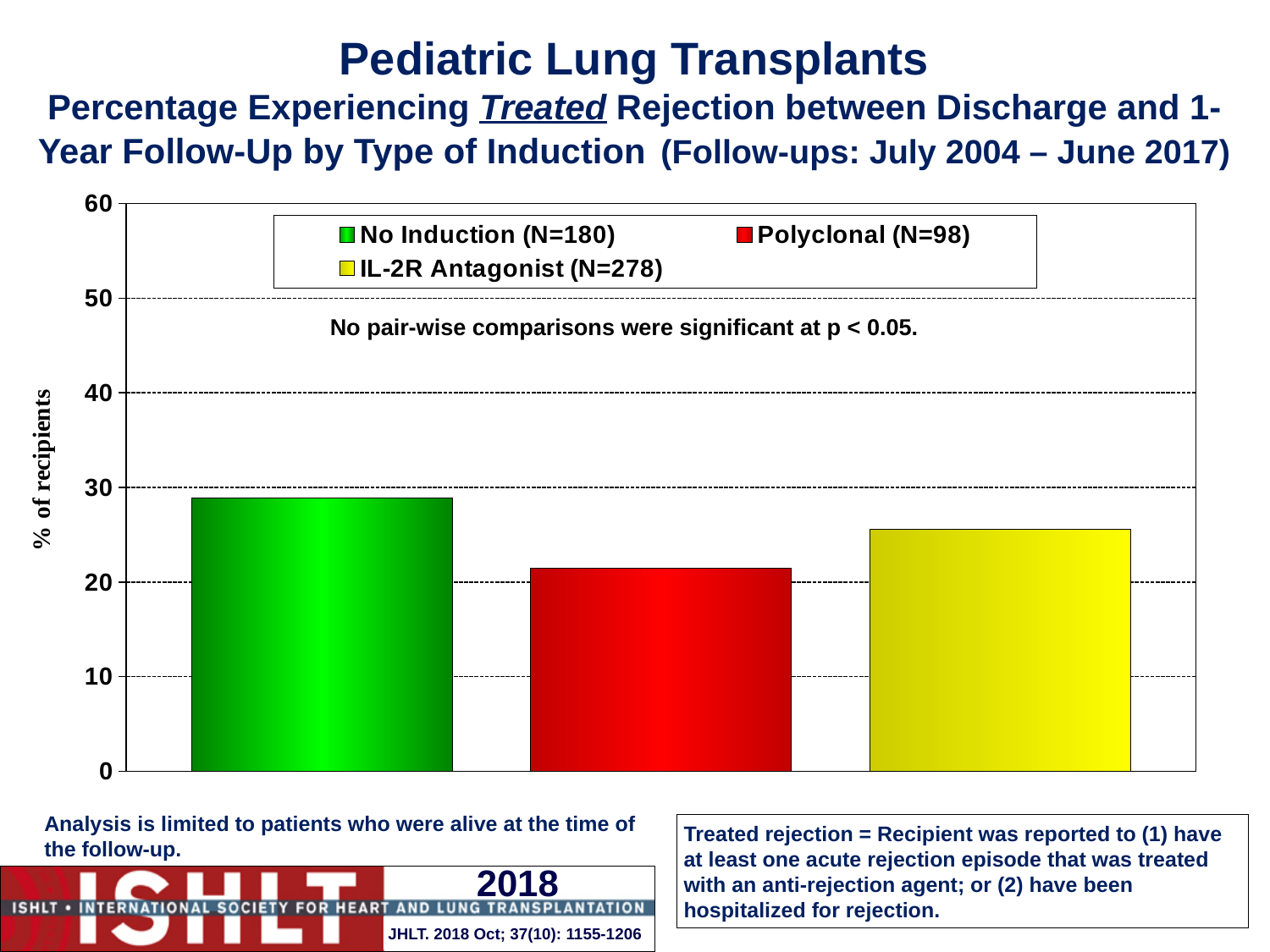
What kind of chart is shown on the slide? bar chart How many series does the legend list? 3 Is the value for IL-2R Antagonist greater or less than 20? greater How many bars are plotted in the chart? 3 Is the value for No Induction greater or less than 20? greater Which is larger, the value for No Induction or the value for Polyclonal? No Induction Which induction type has the lowest percentage of recipients experiencing treated rejection? Polyclonal What is the label on the y-axis of the chart? % of recipients Is the value for Polyclonal greater or less than 30? less What is the sample size (N) shown in the legend for the IL-2R Antagonist group? 278 Which is larger, the value for IL-2R Antagonist or the value for Polyclonal? IL-2R Antagonist Which induction type has the highest percentage of recipients experiencing treated rejection? No Induction